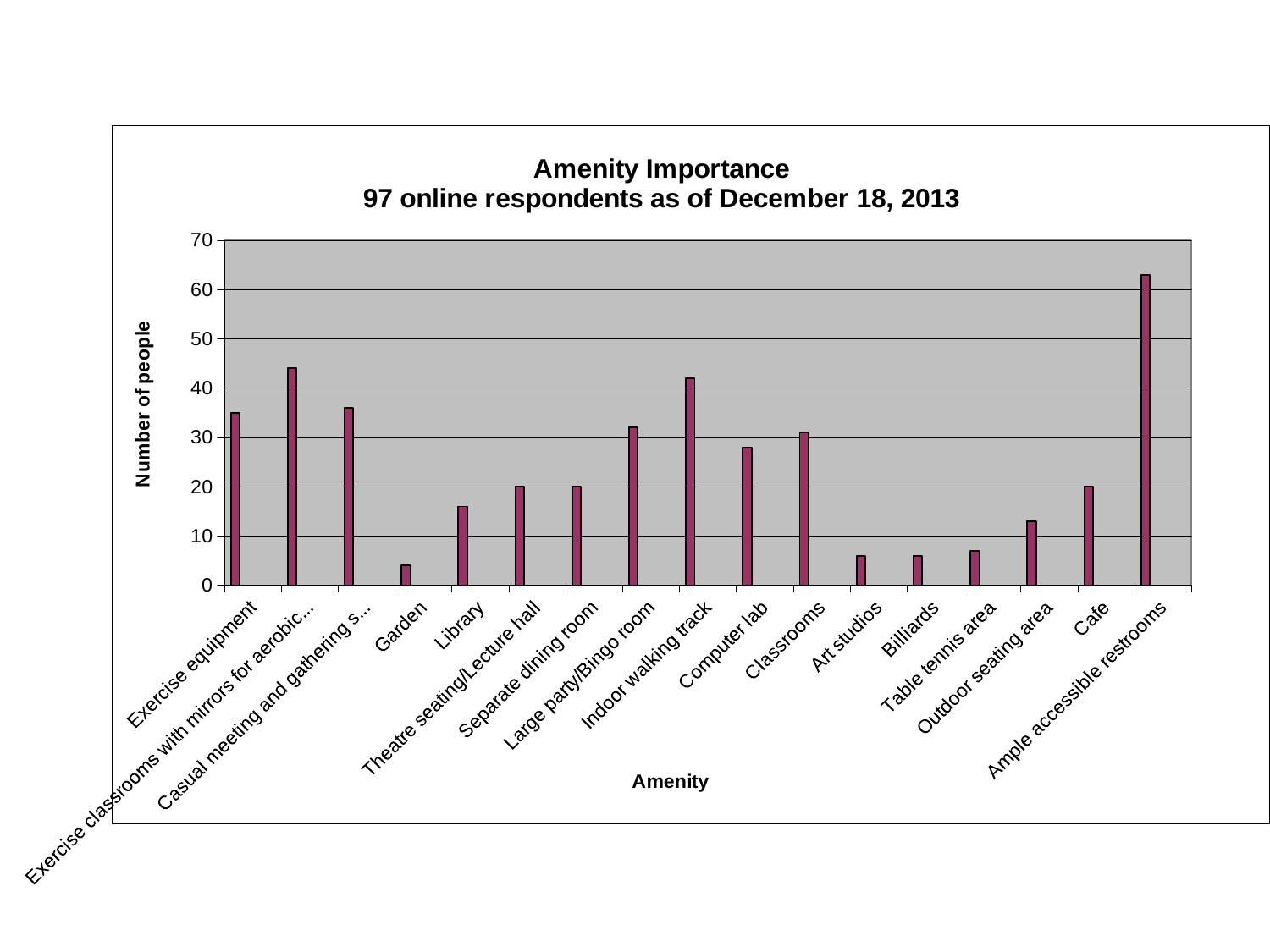
Which has more people, Large party/Bingo room or Computer lab? Large party/Bingo room What is the title of the y axis? Number of people Is the value for Exercise equipment greater or less than 30? greater Is the value for Outdoor seating area greater or less than 10? greater Which amenity has the highest number of people? Ample accessible restrooms Is the value for Library greater or less than 20? less Which amenity has the lowest number of people? Garden How many online respondents does the chart title say there were as of December 18, 2013? 97 How many amenities are shown on the x axis? 17 Which has more people, Outdoor seating area or Table tennis area? Outdoor seating area What kind of chart is shown on the slide? bar chart